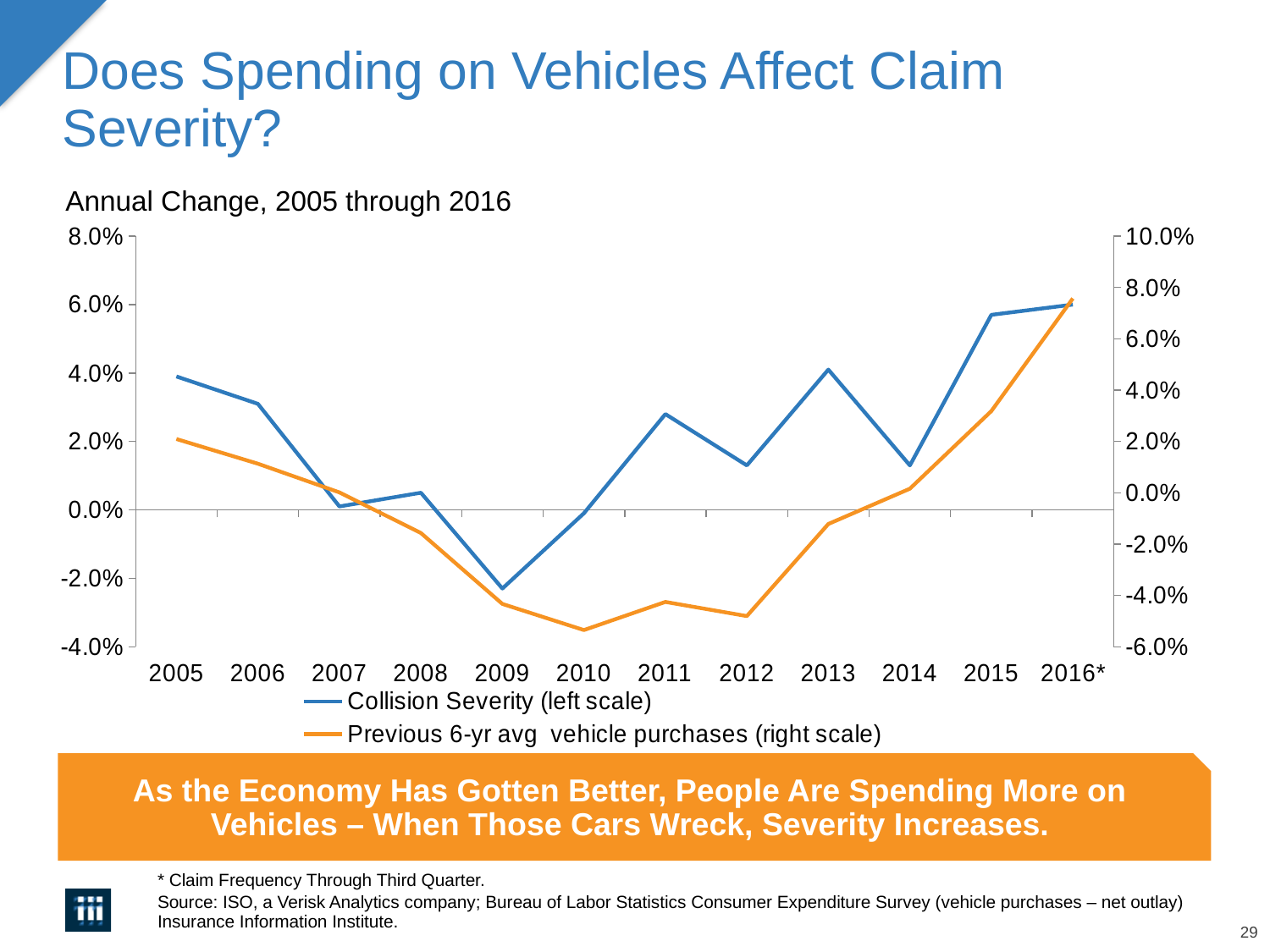
How many years are plotted along the x axis? 12 Which year has the higher Collision Severity value, 2011 or 2012? 2011 What kind of chart is shown on the slide? line chart Does the Collision Severity line rise or fall from 2014 to 2016*? rise In which year is the Previous 6-yr avg vehicle purchases line at its lowest? 2010 How many series does the legend list? 2 Which series is plotted against the right scale? Previous 6-yr avg vehicle purchases In which year is the Collision Severity line at its lowest? 2009 Is the Collision Severity value for 2013 greater or less than 2.0%? greater In which year is the Previous 6-yr avg vehicle purchases line at its highest? 2016* Is the Previous 6-yr avg vehicle purchases value for 2010 greater or less than -4.0% on the right scale? less Is the Collision Severity value for 2009 greater or less than 0.0%? less